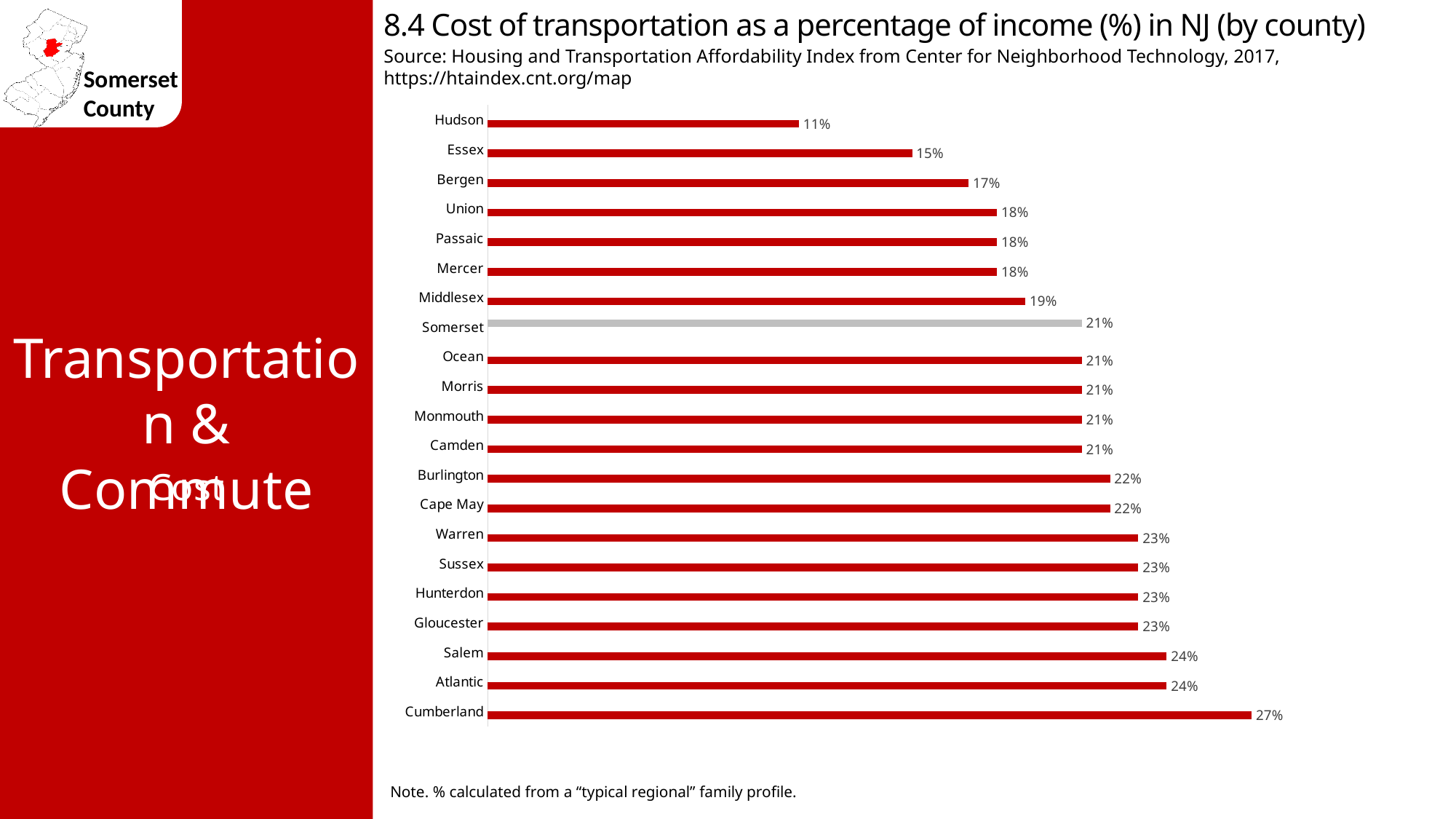
Which county has the lowest cost of transportation as a percentage of income? Hudson What is the cost of transportation as a percentage of income for Somerset County? 21% Which county's bar is shown in gray instead of red? Somerset Which has a higher value, Essex or Salem? Salem What is the difference between the values for Somerset and Bergen? 4% What is the cost of transportation as a percentage of income for Hudson County? 11% What is the difference between the values for Cumberland and Hudson? 16% What type of chart is shown on the slide? Bar chart What is the value shown for Atlantic County? 24% Which county has the highest cost of transportation as a percentage of income? Cumberland What is the value shown for Middlesex? 19% How many counties are shown in the chart? 21